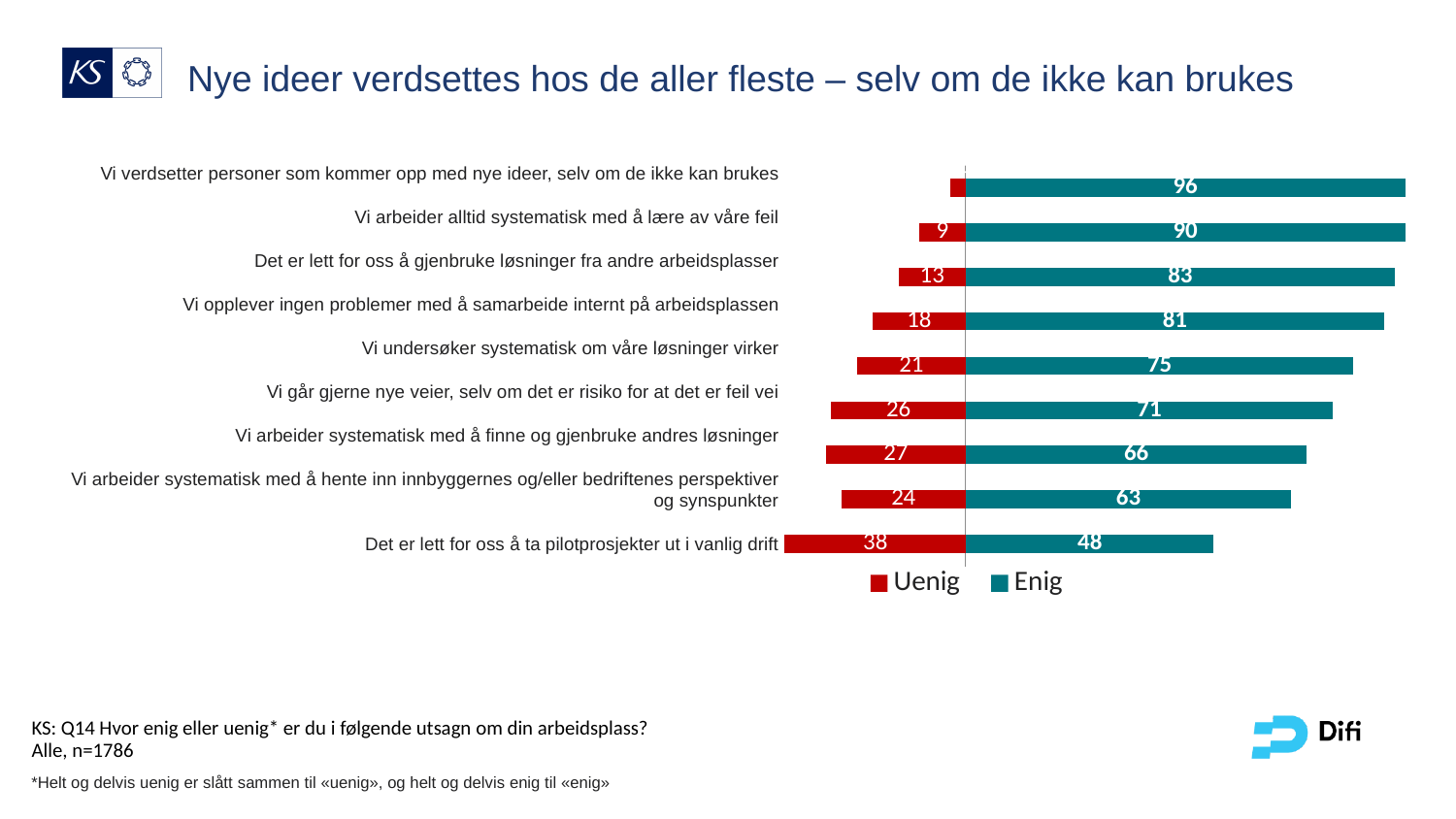
How many series does the legend list? 2 Which statement has the highest Uenig value? Det er lett for oss å ta pilotprosjekter ut i vanlig drift How many statements are shown in the chart? 9 Which statement has the lowest Enig value? Det er lett for oss å ta pilotprosjekter ut i vanlig drift What is the difference between the Enig values for "Vi arbeider alltid systematisk med å lære av våre feil" and "Det er lett for oss å gjenbruke løsninger fra andre arbeidsplasser"? 7 What is the Uenig value for "Vi arbeider alltid systematisk med å lære av våre feil"? 9 Which colour represents the Enig series? Teal What is the Enig value for "Vi undersøker systematisk om våre løsninger virker"? 75 Which is larger: the Uenig value for "Vi går gjerne nye veier, selv om det er risiko for at det er feil vei" or the Uenig value for "Vi undersøker systematisk om våre løsninger virker"? Vi går gjerne nye veier, selv om det er risiko for at det er feil vei What is the Uenig value for "Det er lett for oss å ta pilotprosjekter ut i vanlig drift"? 38 What kind of chart is shown on the slide? Bar chart What is the Enig value for "Vi verdsetter personer som kommer opp med nye ideer, selv om de ikke kan brukes"? 96